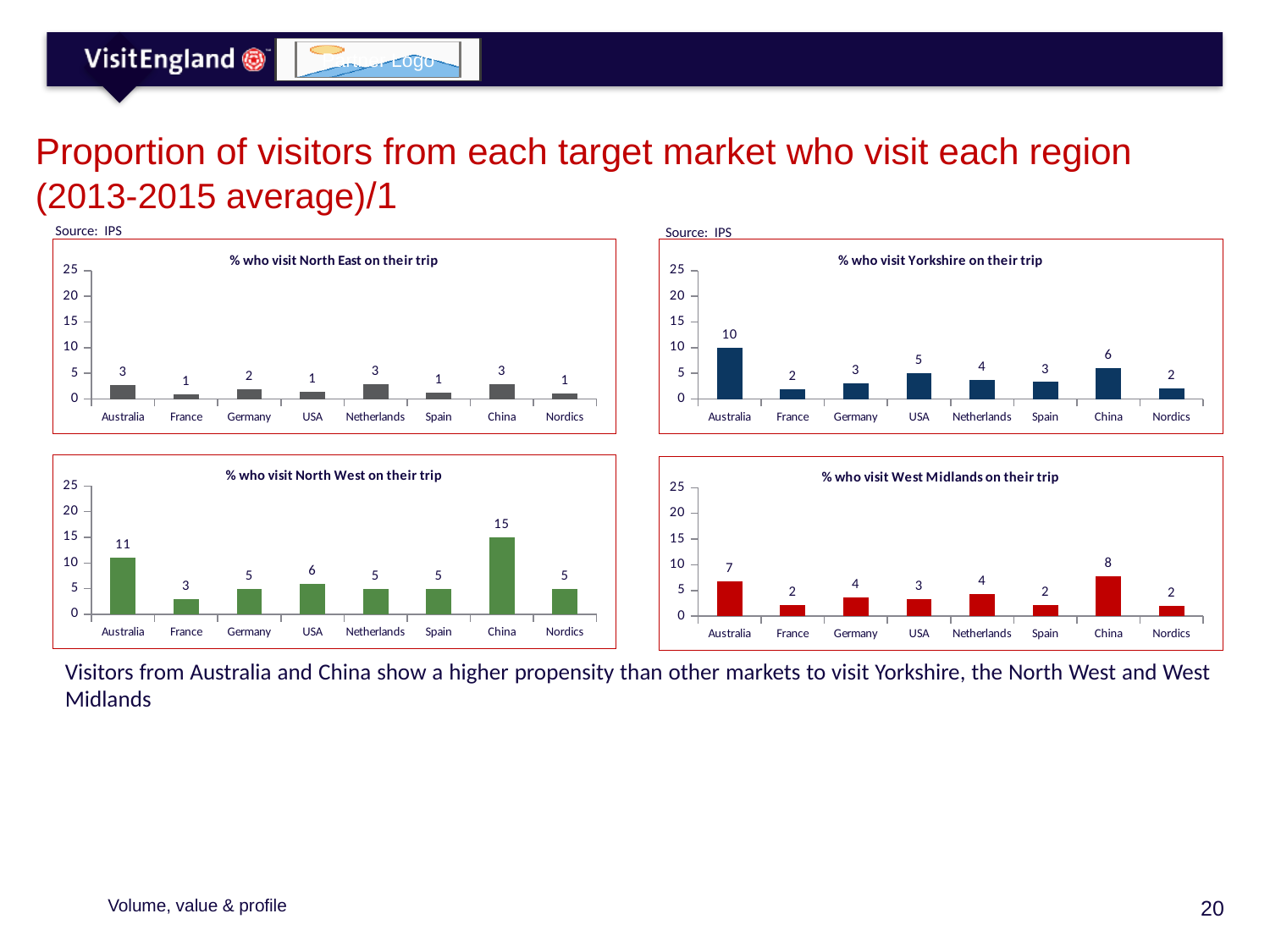
In the '% who visit Yorkshire on their trip' chart, is the value for Australia greater or less than 5? greater In the '% who visit North West on their trip' chart, what is the value for China? 15 How many markets are shown on the x axis of the '% who visit West Midlands on their trip' chart? 8 In the '% who visit Yorkshire on their trip' chart, which market has the highest value? Australia What colour are the bars in the '% who visit North West on their trip' chart? Green In the '% who visit West Midlands on their trip' chart, what is the value for Netherlands? 4 In the '% who visit North West on their trip' chart, which is larger, the value for Australia or the value for USA? Australia In the '% who visit Yorkshire on their trip' chart, what is the difference between the values for Australia and France? 8 In the '% who visit West Midlands on their trip' chart, what is the difference between the values for China and Australia? 1 In the '% who visit North East on their trip' chart, what is the value for Netherlands? 3 In the '% who visit North West on their trip' chart, which market has the lowest value? France What kind of chart is the '% who visit North East on their trip' chart? Bar chart